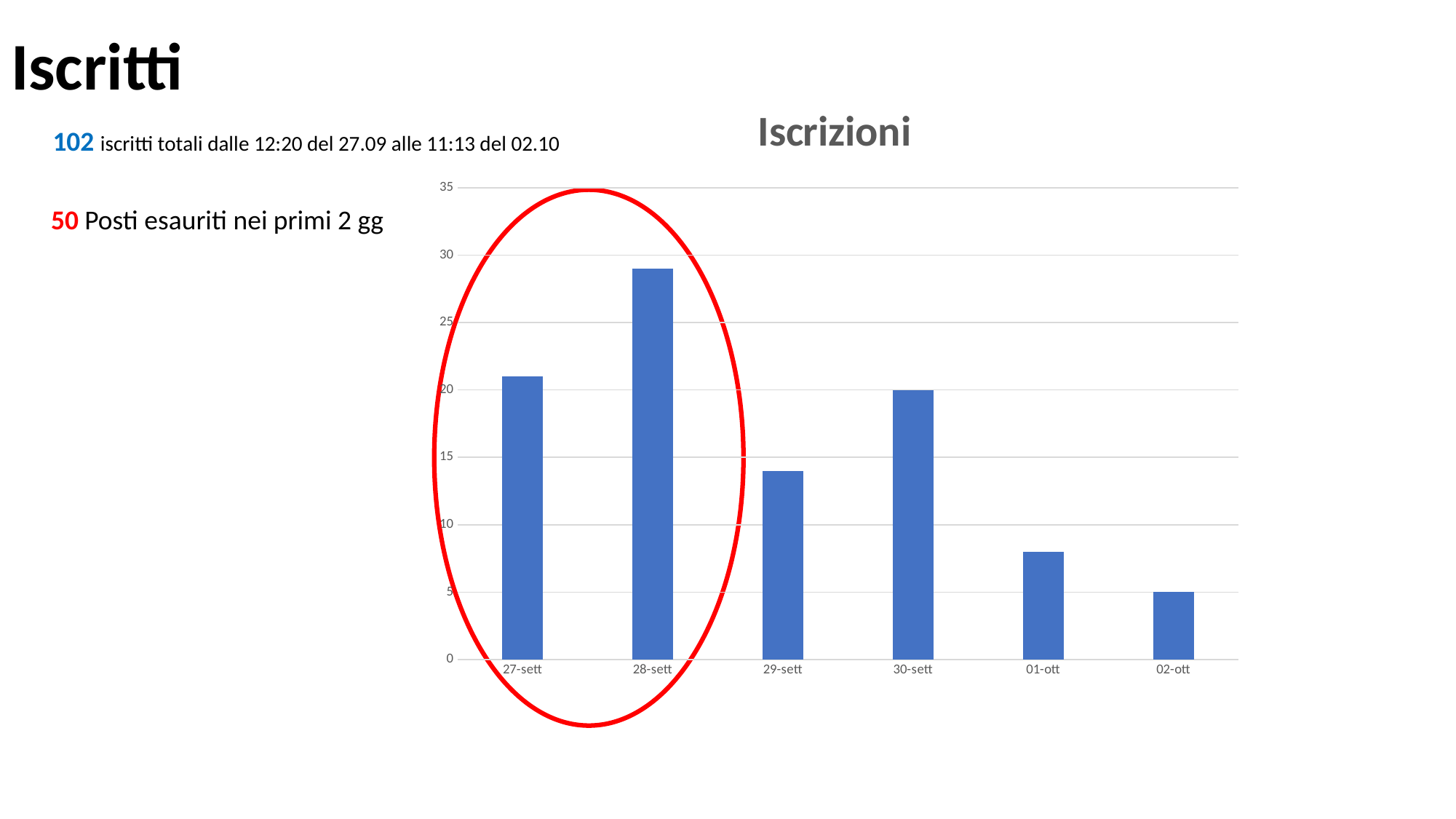
Which category has the highest value in the chart? 28-sett Is the value for 29-sett greater or less than 15? less What type of chart is shown on the slide? bar chart Is the value for 01-ott greater or less than 10? less Which is larger, the value for 27-sett or the value for 29-sett? 27-sett What is the value for 30-sett? 20 Do the values rise or fall from 30-sett to 02-ott? fall What is the value for 02-ott? 5 Is the value for 28-sett greater or less than 25? greater What is the title of the chart? Iscrizioni Which category has the lowest value in the chart? 02-ott How many categories are shown on the x axis of the chart? 6